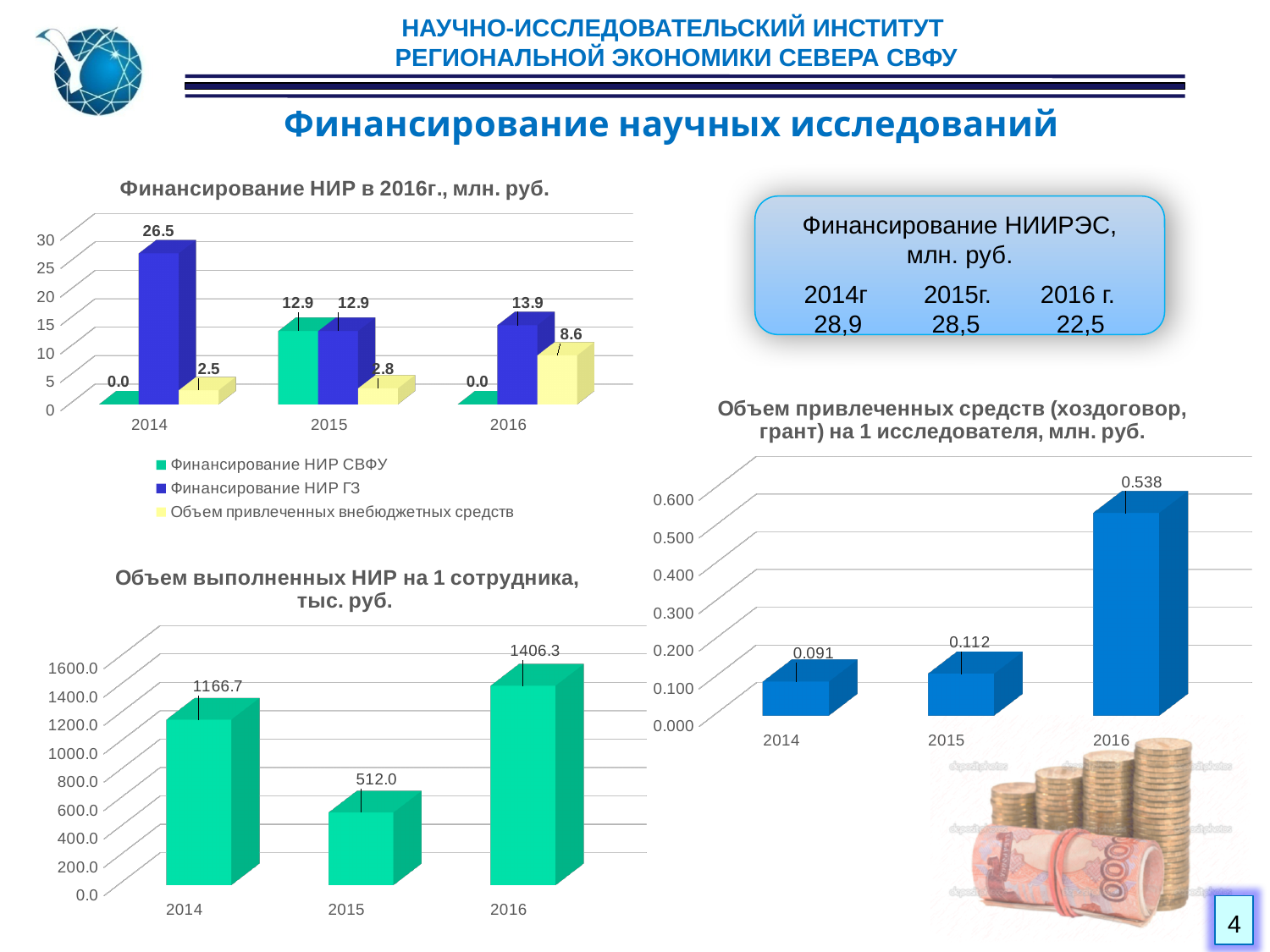
In the chart 'Финансирование НИР в 2016г., млн. руб.', what is the value of Объем привлеченных внебюджетных средств in 2016? 8.6 In the chart 'Объем привлеченных средств (хоздоговор, грант) на 1 исследователя, млн. руб.', how many years are shown on the x axis? 3 In the chart 'Объем выполненных НИР на 1 сотрудника, тыс. руб.', what is the difference between the 2016 and 2014 values? 239.6 In the chart 'Финансирование НИР в 2016г., млн. руб.', what is the value for Финансирование НИР ГЗ in 2014? 26.5 What kind of chart is 'Объем выполненных НИР на 1 сотрудника, тыс. руб.'? Bar chart In the chart 'Объем выполненных НИР на 1 сотрудника, тыс. руб.', which year has the highest value? 2016 In the chart 'Объем выполненных НИР на 1 сотрудника, тыс. руб.', what is the value for 2015? 512.0 In the chart 'Финансирование НИР в 2016г., млн. руб.', how many series does the legend list? 3 In the chart 'Объем привлеченных средств (хоздоговор, грант) на 1 исследователя, млн. руб.', what is the value for 2016? 0.538 In the chart 'Объем привлеченных средств (хоздоговор, грант) на 1 исследователя, млн. руб.', which year has the lowest value? 2014 In the chart 'Финансирование НИР в 2016г., млн. руб.', which year has the highest value for Объем привлеченных внебюджетных средств? 2016 In the chart 'Финансирование НИР в 2016г., млн. руб.', what is the difference between Финансирование НИР ГЗ in 2014 and in 2016? 12.6